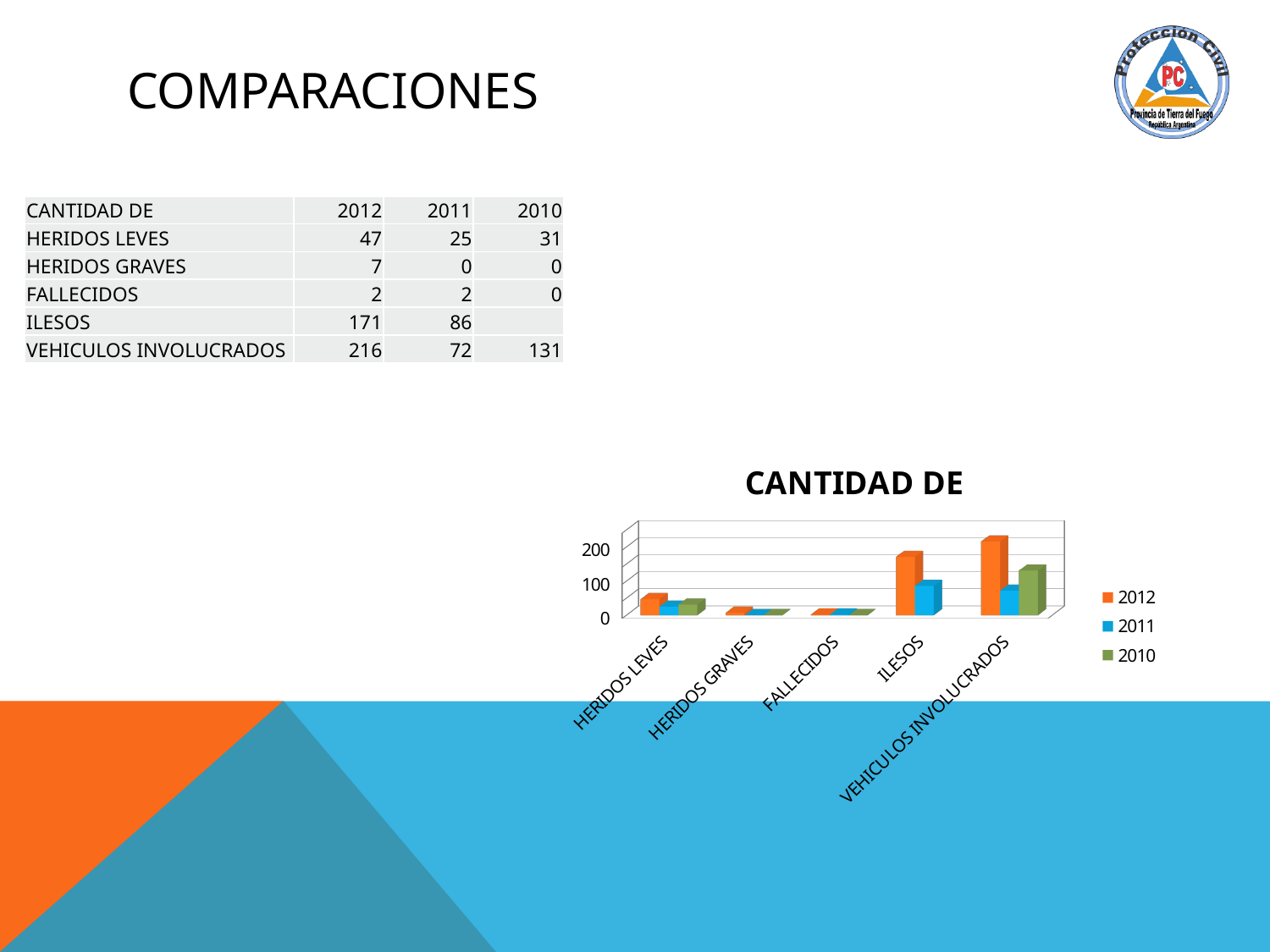
What is the difference between the 2012 and 2011 values for VEHICULOS INVOLUCRADOS? 144 What kind of chart is shown under the title CANTIDAD DE? bar chart Which category has the highest 2012 value in the CANTIDAD DE chart? VEHICULOS INVOLUCRADOS Is the 2011 value for VEHICULOS INVOLUCRADOS greater or less than 100? less How many series does the legend of the CANTIDAD DE chart list? 3 According to the slide, what is the 2011 value for ILESOS? 86 According to the slide, what is the 2010 value for HERIDOS LEVES? 31 According to the slide, what is the 2012 value for VEHICULOS INVOLUCRADOS? 216 Which series is shown in orange in the CANTIDAD DE chart? 2012 Which is larger for HERIDOS LEVES, the 2012 value or the 2011 value? 2012 Is the 2012 value for ILESOS greater or less than 100? greater How many categories are shown on the x axis of the CANTIDAD DE chart? 5